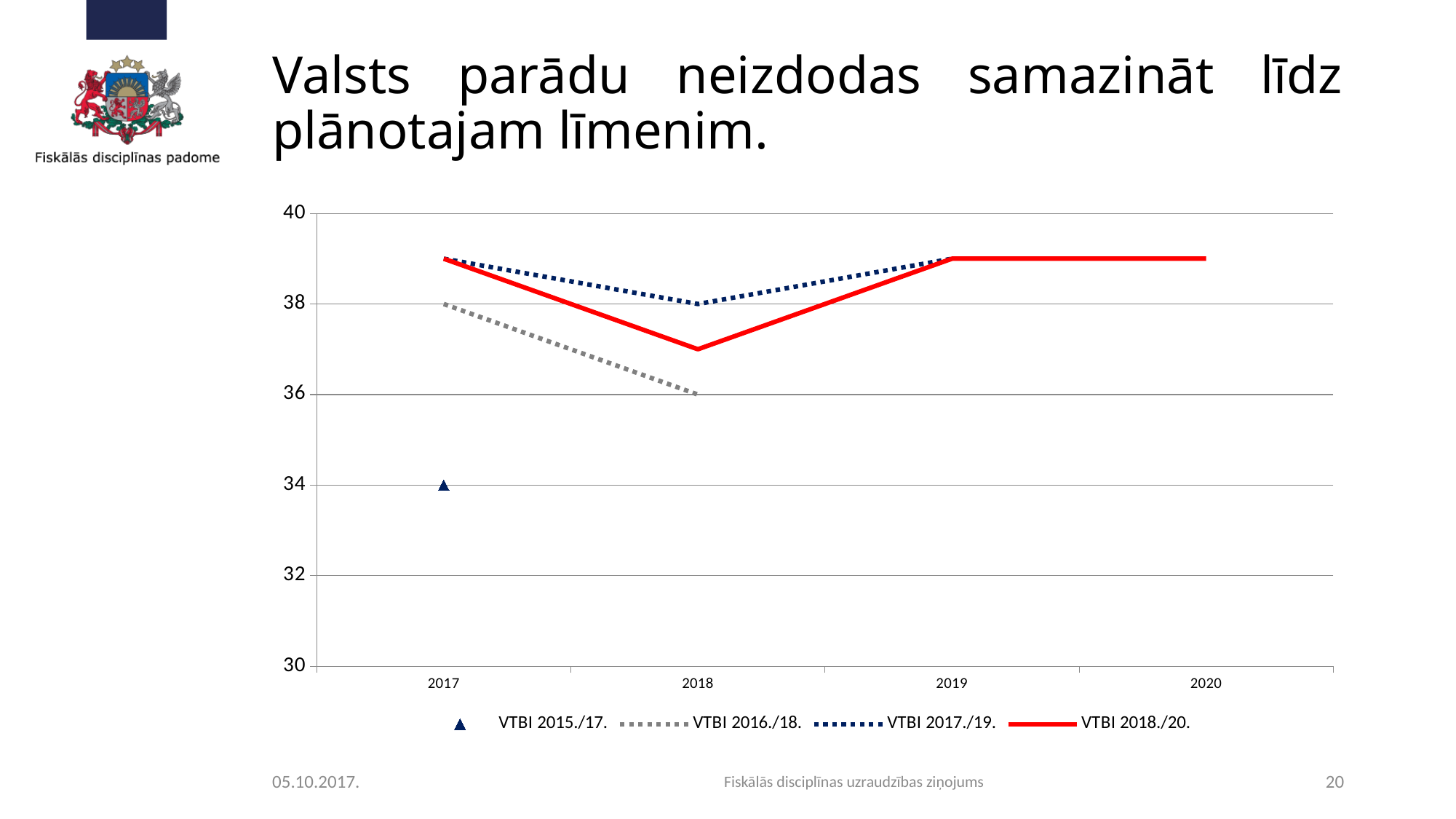
How many years are shown on the x axis? 4 What is the value of VTBI 2017./19. for 2018? 38 Is the value for VTBI 2018./20. in 2018 greater or less than 38? less By how much does VTBI 2016./18. fall from 2017 to 2018? 2 What is the value of VTBI 2016./18. for 2018? 36 What is the value of VTBI 2015./17. for 2017? 34 What colour is the line for VTBI 2018./20.? red What is the value of VTBI 2016./18. for 2017? 38 How many series does the legend list? 4 What kind of chart is shown on the slide? line chart Which series has the higher value in 2018, VTBI 2017./19. or VTBI 2018./20.? VTBI 2017./19. Does VTBI 2016./18. rise or fall from 2017 to 2018? fall